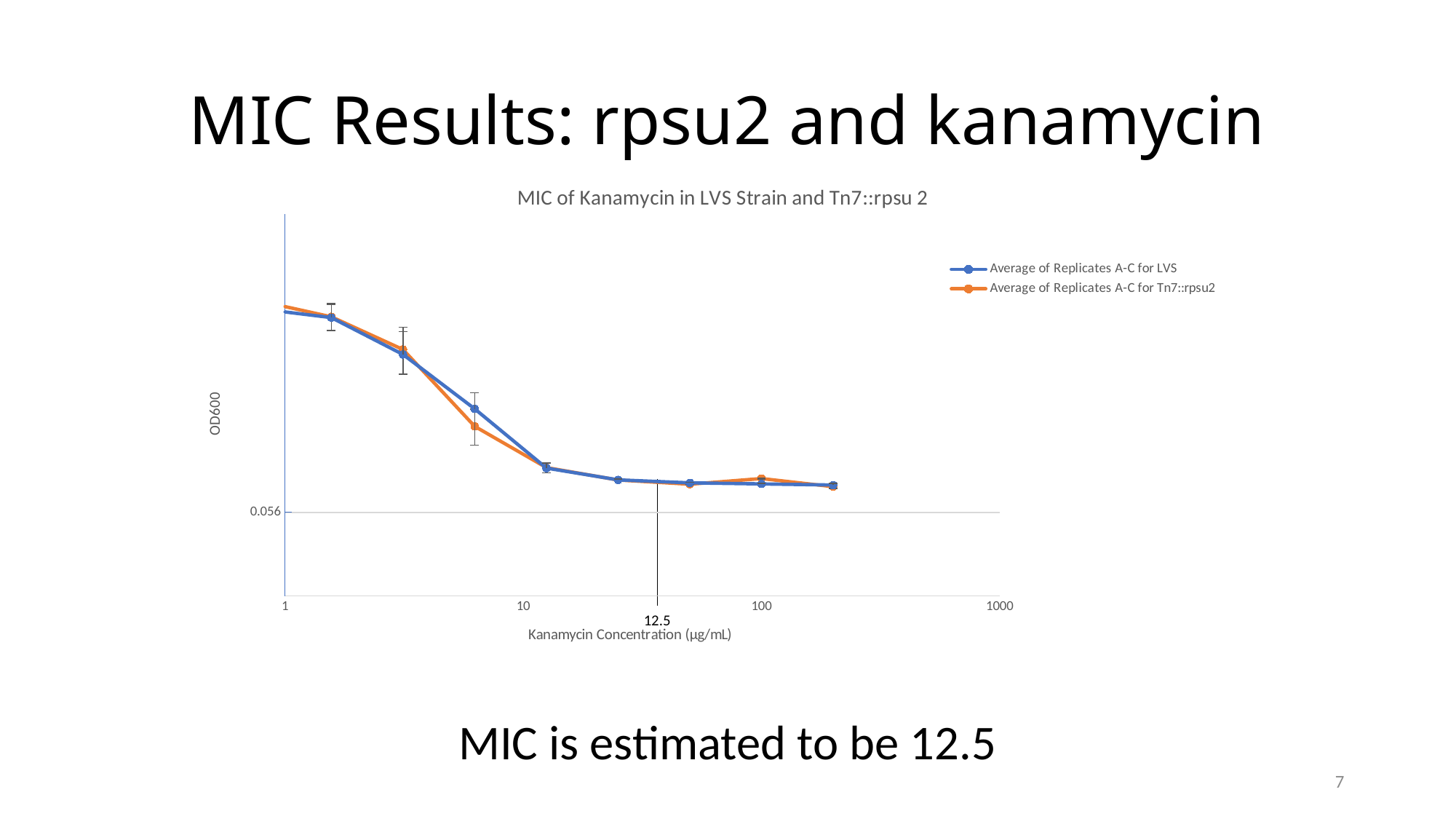
Which series is plotted in orange? Average of Replicates A-C for Tn7::rpsu2 As kanamycin concentration increases along the x axis, do the OD600 values rise or fall? Fall Is the OD600 value for Average of Replicates A-C for LVS at 100 µg/mL greater or less than 0.056? greater What kind of chart is shown on the slide? Line chart What is the title of the chart? MIC of Kanamycin in LVS Strain and Tn7::rpsu 2 What kanamycin concentration is marked on the x axis as the estimated MIC? 12.5 How many series does the chart's legend list? 2 At the data point just below 10 µg/mL on the x axis, which series has the higher OD600: Average of Replicates A-C for LVS or Average of Replicates A-C for Tn7::rpsu2? Average of Replicates A-C for LVS